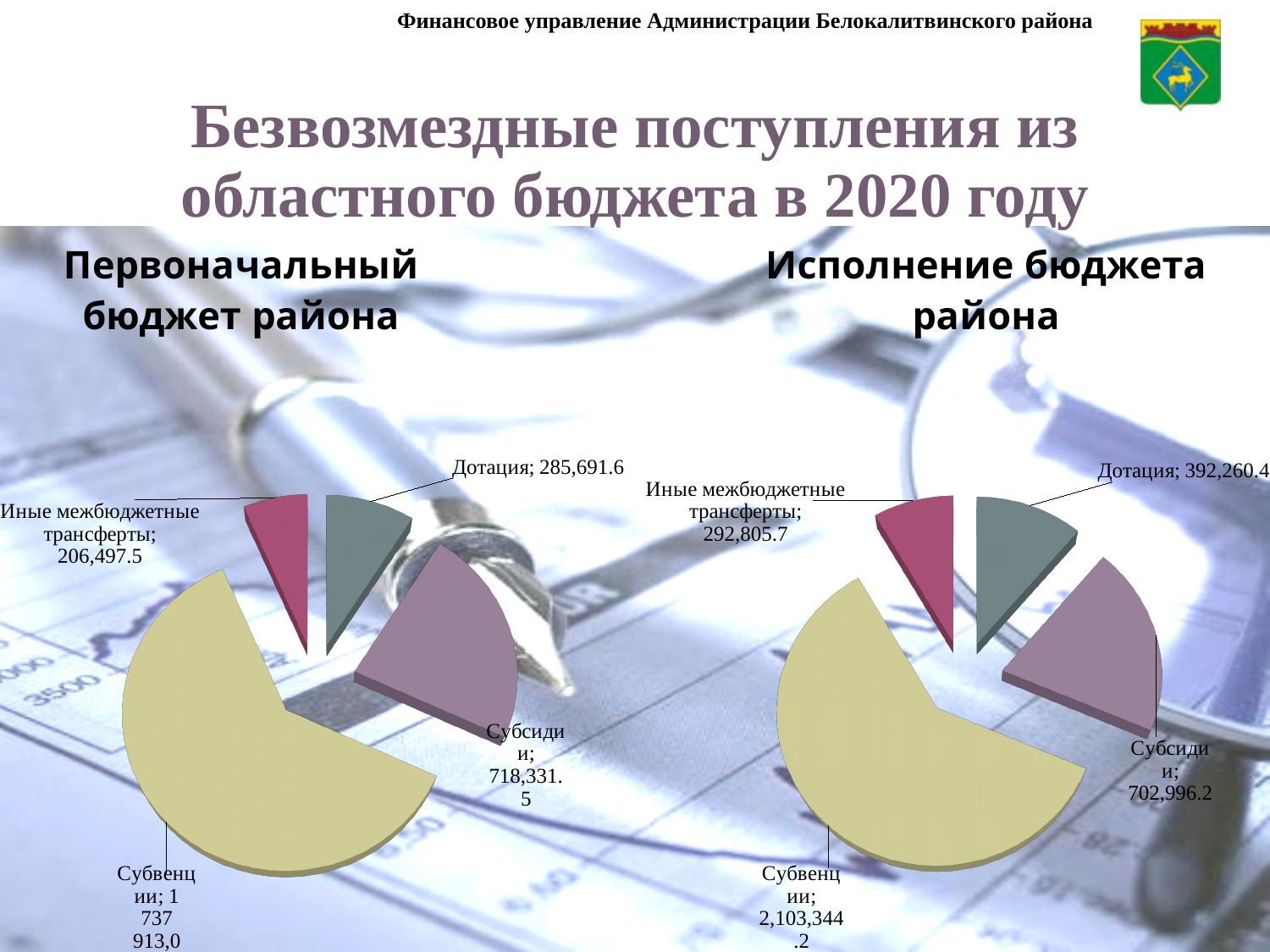
Is the value for Дотация larger on the left chart (Первоначальный бюджет района) or on the right chart (Исполнение бюджета района)? Right chart (Исполнение бюджета района) On the right chart (Исполнение бюджета района), what is the value for Иные межбюджетные трансферты? 292,805.7 On the right chart (Исполнение бюджета района), which is larger: Дотация or Субсидии? Субсидии On the right chart (Исполнение бюджета района), what is the difference between Субсидии and Иные межбюджетные трансферты? 410,190.5 What type of chart is used on the right (Исполнение бюджета района)? Pie chart On the right chart (Исполнение бюджета района), which category has the largest slice? Субвенции On the left chart (Первоначальный бюджет района), what is the difference between Субсидии and Дотация? 432,639.9 On the left chart (Первоначальный бюджет района), which category has the smallest slice? Иные межбюджетные трансферты How many categories does the left chart (Первоначальный бюджет района) show? 4 On the left chart (Первоначальный бюджет района), what is the value for Дотация? 285,691.6 On the right chart (Исполнение бюджета района), what is the value for Субвенции? 2,103,344.2 On the left chart (Первоначальный бюджет района), what is the value for Субсидии? 718,331.5